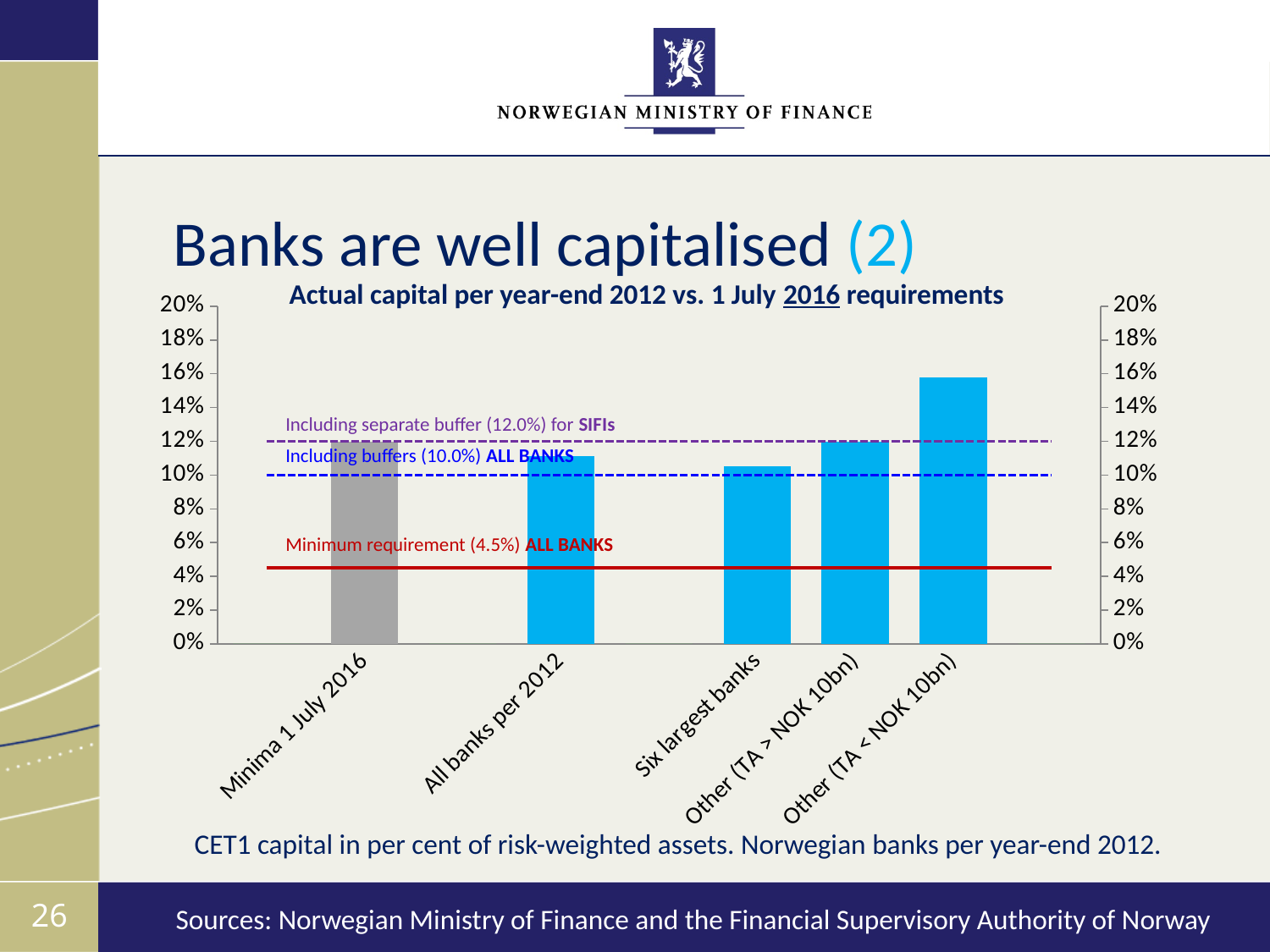
What colour is the bar for Minima 1 July 2016? grey What kind of chart is shown on the slide? bar chart Which is larger, the bar for Other (TA < NOK 10bn) or the bar for Six largest banks? Other (TA < NOK 10bn) What is the title of the chart? Actual capital per year-end 2012 vs. 1 July 2016 requirements What level is the line 'Including buffers ALL BANKS' set at? 10.0% Is the value for Other (TA < NOK 10bn) greater or less than 14%? greater Which category has the highest bar in the chart? Other (TA < NOK 10bn) What level is the minimum requirement line for all banks set at? 4.5% Is the value for Six largest banks greater or less than 12%? less What is the difference between the SIFI buffer level (12.0%) and the minimum requirement (4.5%)? 7.5 percentage points What level is the line 'Including separate buffer for SIFIs' set at? 12.0% How many bars (categories) are plotted in the chart? 5